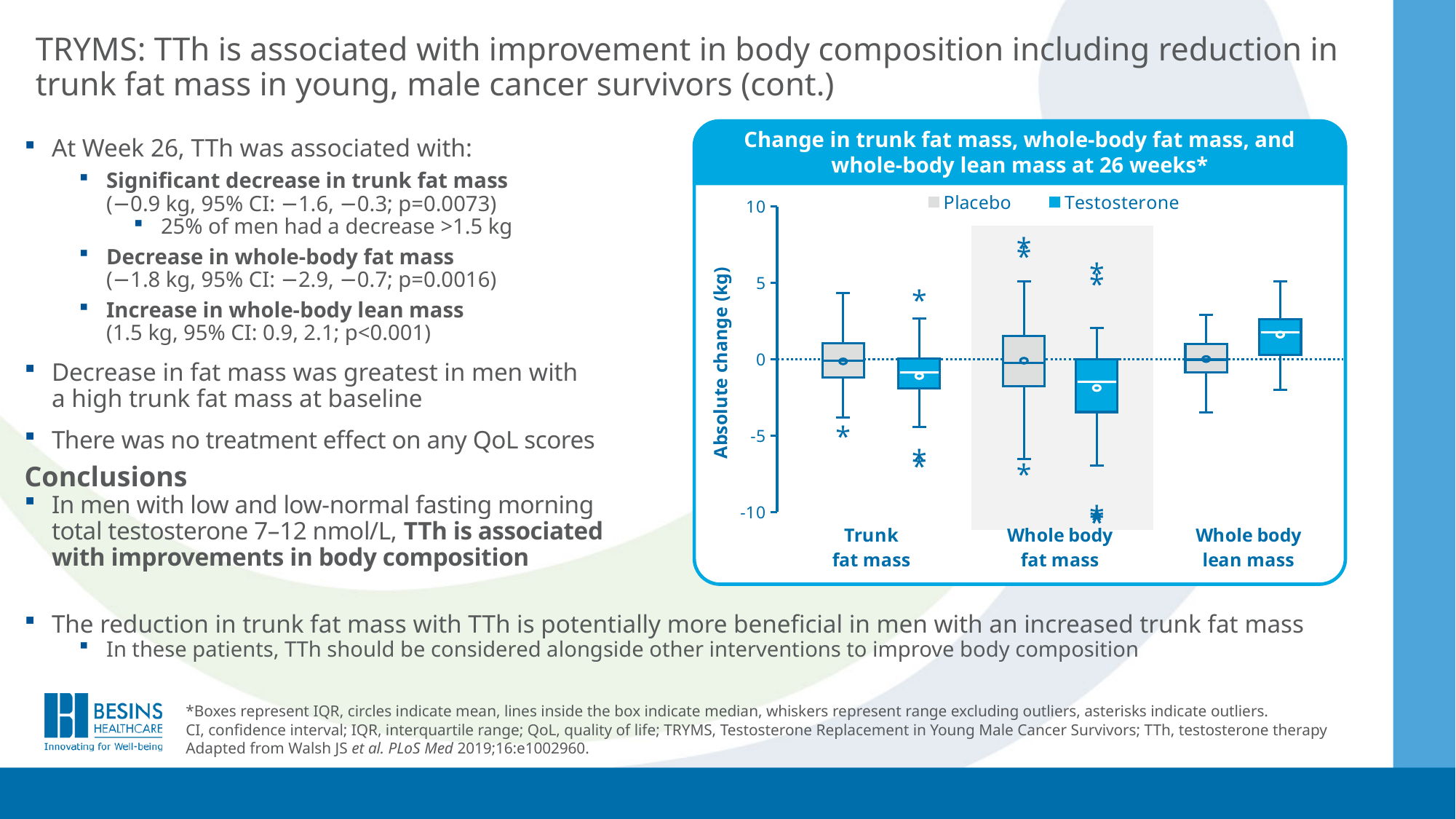
What is the label of the chart's y axis? Absolute change (kg) How many series does the chart legend list? 2 How many categories are shown on the x axis of the chart? 3 Is the Testosterone mean for whole body fat mass greater or less than 0? less For whole body fat mass, which series has the lower mean change, Placebo or Testosterone? Testosterone Is the Testosterone mean for whole body lean mass greater or less than 0? greater Is the Testosterone mean for whole body fat mass greater or less than -5? greater Which category has the highest Testosterone mean change? Whole body lean mass For whole body lean mass, which series has the higher mean change, Placebo or Testosterone? Testosterone What kind of chart is shown on the slide? Box plot (box-and-whisker chart) What are the two series named in the chart legend? Placebo and Testosterone